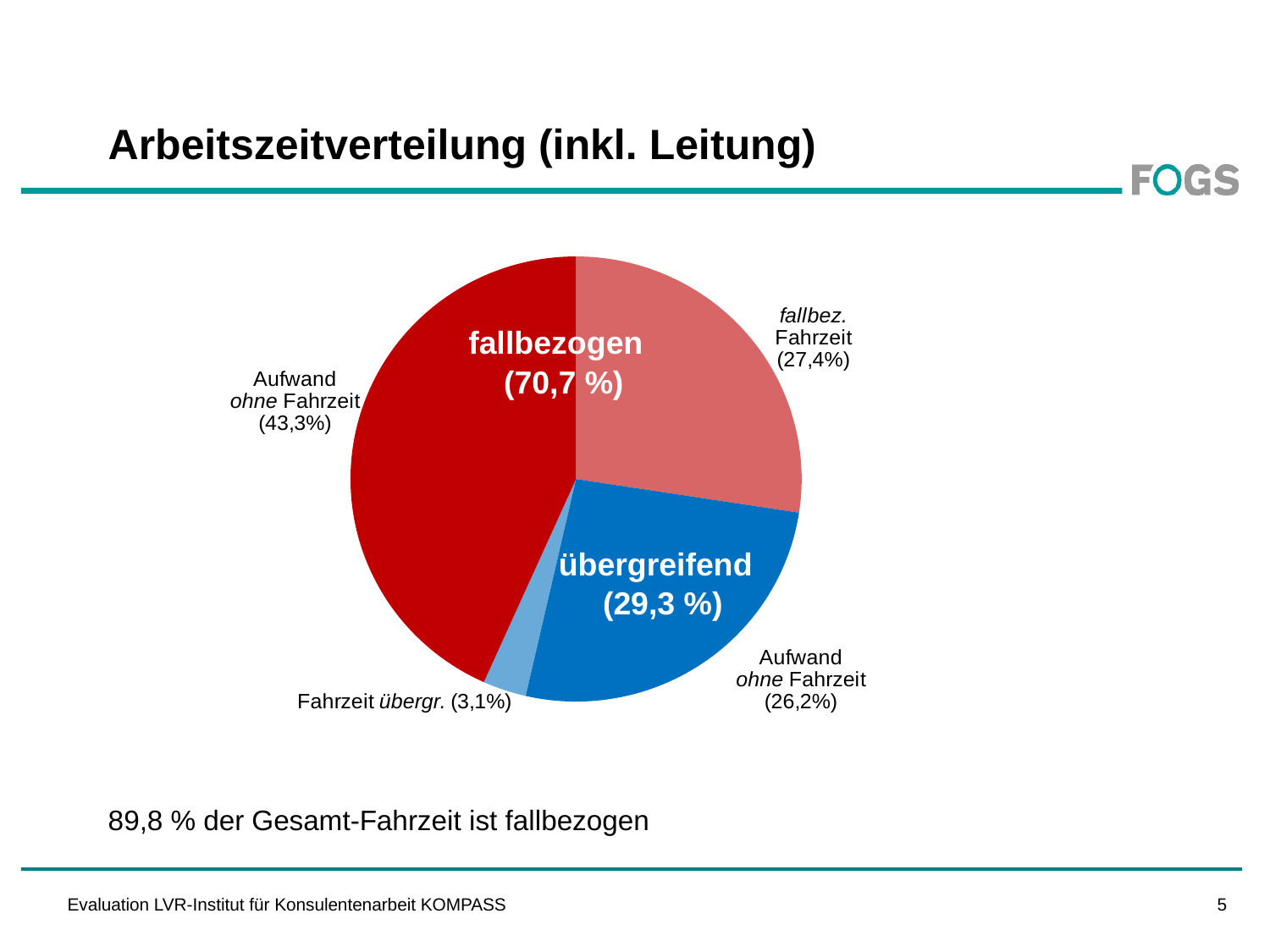
What is the difference between the 'fallbez. Fahrzeit' slice (27,4%) and the 'Fahrzeit übergr.' slice (3,1%)? 24,3% What share of the pie is labelled 'fallbez. Fahrzeit'? 27,4% Which slice of the pie chart is the largest? Aufwand ohne Fahrzeit (43,3%) How many slices does the pie chart have? 4 What share of the pie is labelled 'Fahrzeit übergr.'? 3,1% What total percentage is given for the 'fallbezogen' group? 70,7 % What is the title of the slide with the pie chart? Arbeitszeitverteilung (inkl. Leitung) What total percentage is given for the 'übergreifend' group? 29,3 % What kind of chart is shown on the slide? pie chart What percentage is shown for the 'Aufwand ohne Fahrzeit' slice within the 'übergreifend' group? 26,2% Which slice of the pie chart is the smallest? Fahrzeit übergr. (3,1%) What percentage is shown for the 'Aufwand ohne Fahrzeit' slice within the 'fallbezogen' group? 43,3%